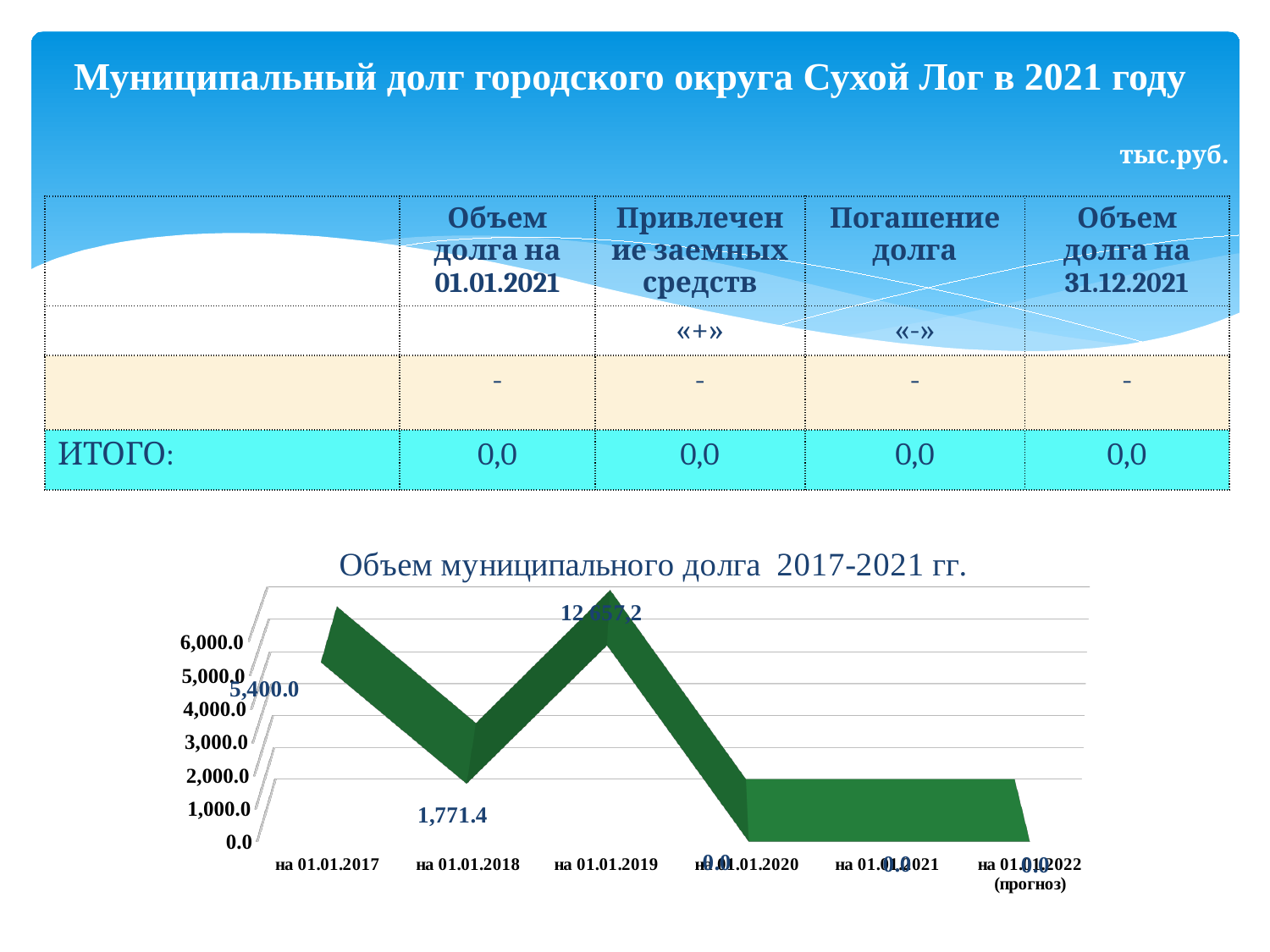
What is the value for на 01.01.2021 in the chart? 0.0 What is the difference between the values for на 01.01.2017 and на 01.01.2018 in the chart? 3,628.6 How many data points are plotted in the chart? 6 What is the value for на 01.01.2017 in the chart? 5,400.0 Which is larger in the chart: the value for на 01.01.2017 or на 01.01.2018? на 01.01.2017 What is the value for на 01.01.2020 in the chart? 0.0 What is the value for на 01.01.2018 in the chart? 1,771.4 What type of chart is shown on the slide? line chart Which date has the highest value in the chart? на 01.01.2019 Between на 01.01.2019 and на 01.01.2020, does the value in the chart rise or fall? fall What is the title of the chart on the slide? Объем муниципального долга 2017-2021 гг.